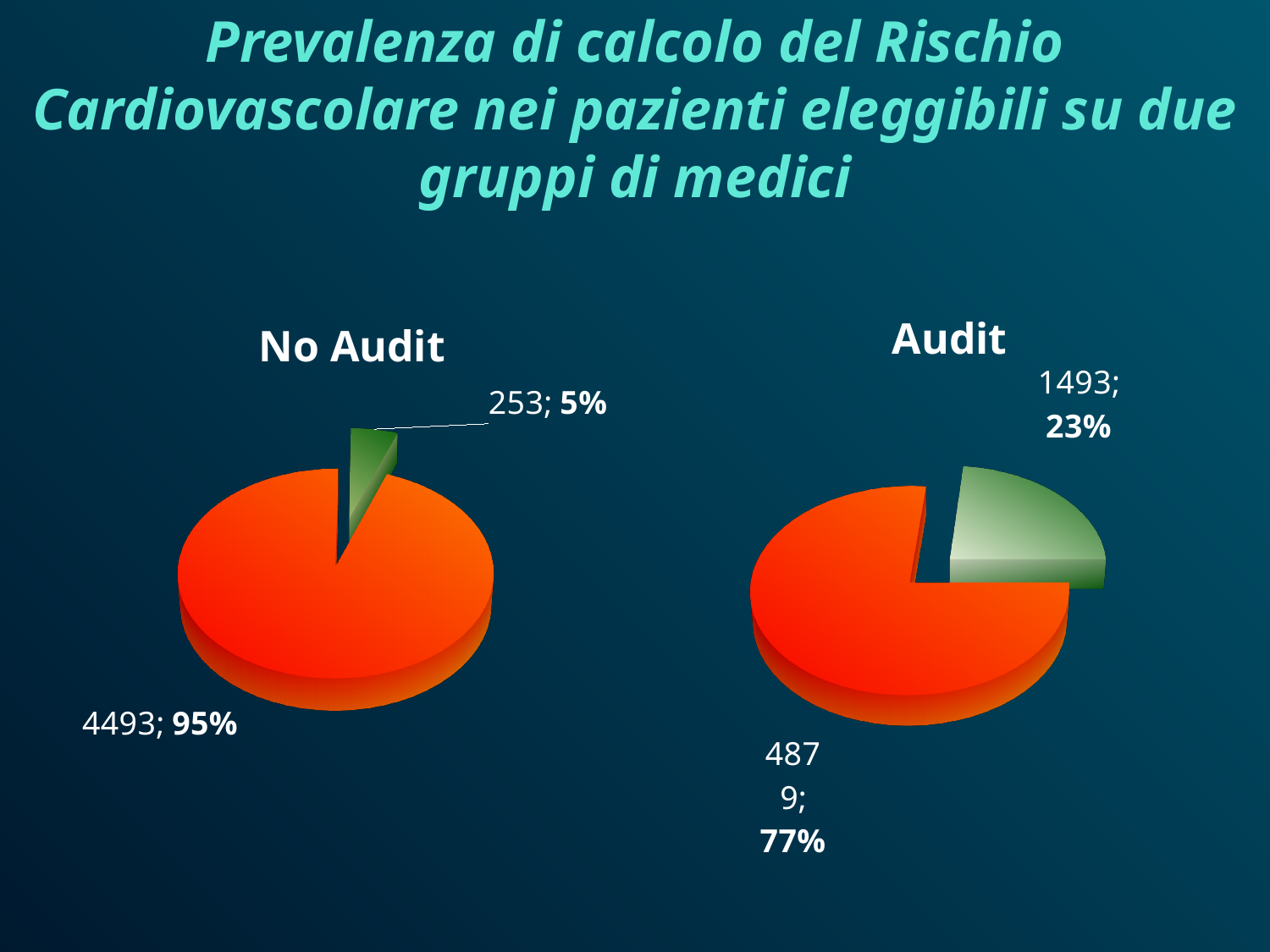
What kind of chart is the "No Audit" chart? pie chart In the "No Audit" pie chart, what is the difference between the orange slice value and the green slice value? 4240 In the "No Audit" pie chart, what value is shown for the green slice? 253 How many slices does the "Audit" pie chart have? 2 What is the title of the pie chart on the right of the slide? Audit In the "Audit" pie chart, what share of the pie does the green slice represent? 23% In the "No Audit" pie chart, what share of the pie does the green slice represent? 5% In the "Audit" pie chart, what value is shown for the green slice? 1493 In the "Audit" pie chart, what share of the pie does the orange slice represent? 77% Which chart has the larger green slice share, "No Audit" or "Audit"? Audit In the "No Audit" pie chart, what value is shown for the orange slice? 4493